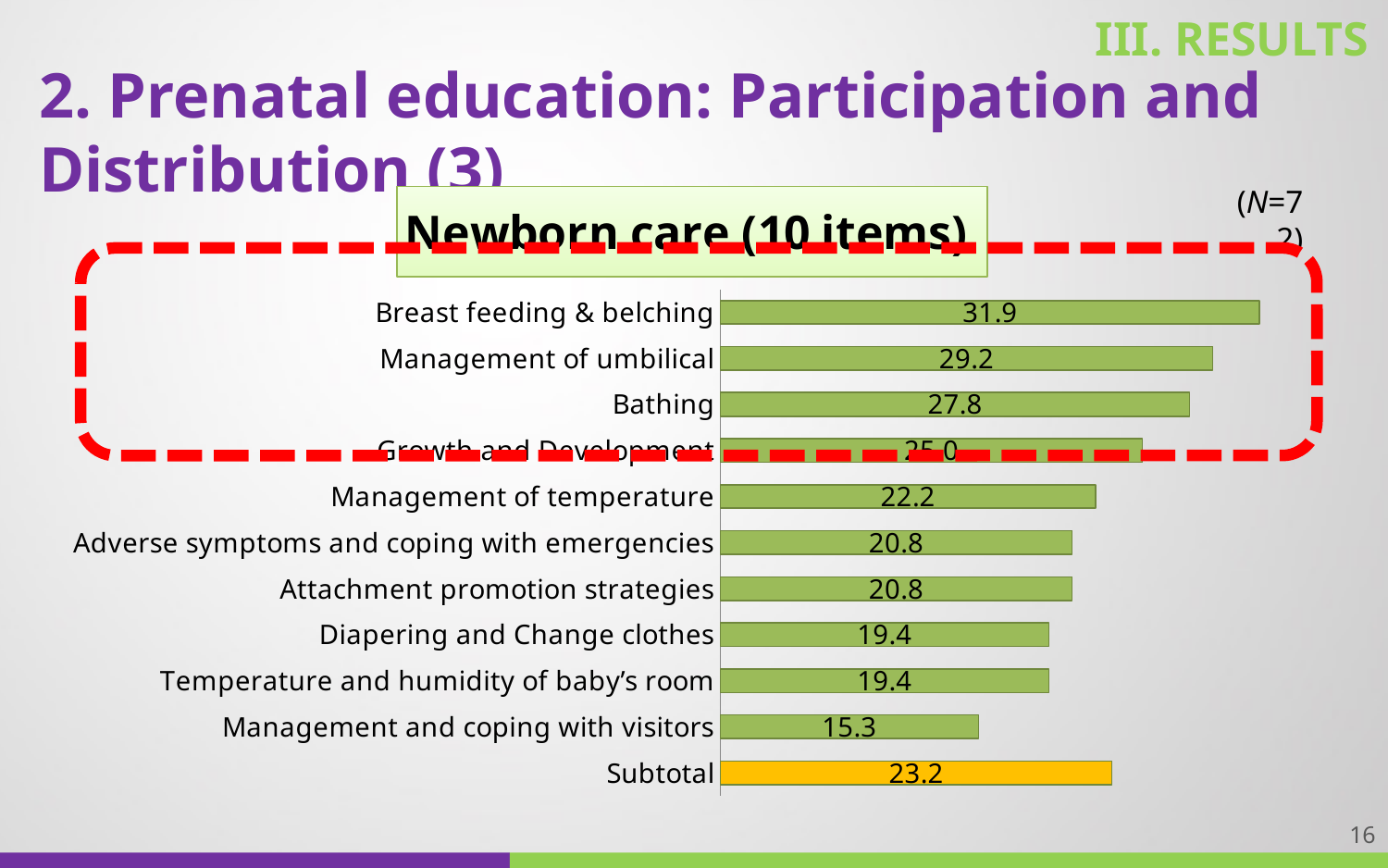
How many bars are plotted in the chart, including Subtotal? 11 What is the value for Management and coping with visitors? 15.3 What is the difference between the values for Breast feeding & belching and Management and coping with visitors? 16.6 Excluding Subtotal, which category has the lowest value? Management and coping with visitors Which category has the highest value? Breast feeding & belching What is the value shown for Subtotal? 23.2 What is the difference between the values for Management of umbilical and Bathing? 1.4 What kind of chart is shown on the slide? Bar chart What is the title of the chart? Newborn care (10 items) What is the value for Bathing? 27.8 Which is larger, the value for Bathing or the value for Management of temperature? Bathing What is the value for Breast feeding & belching? 31.9